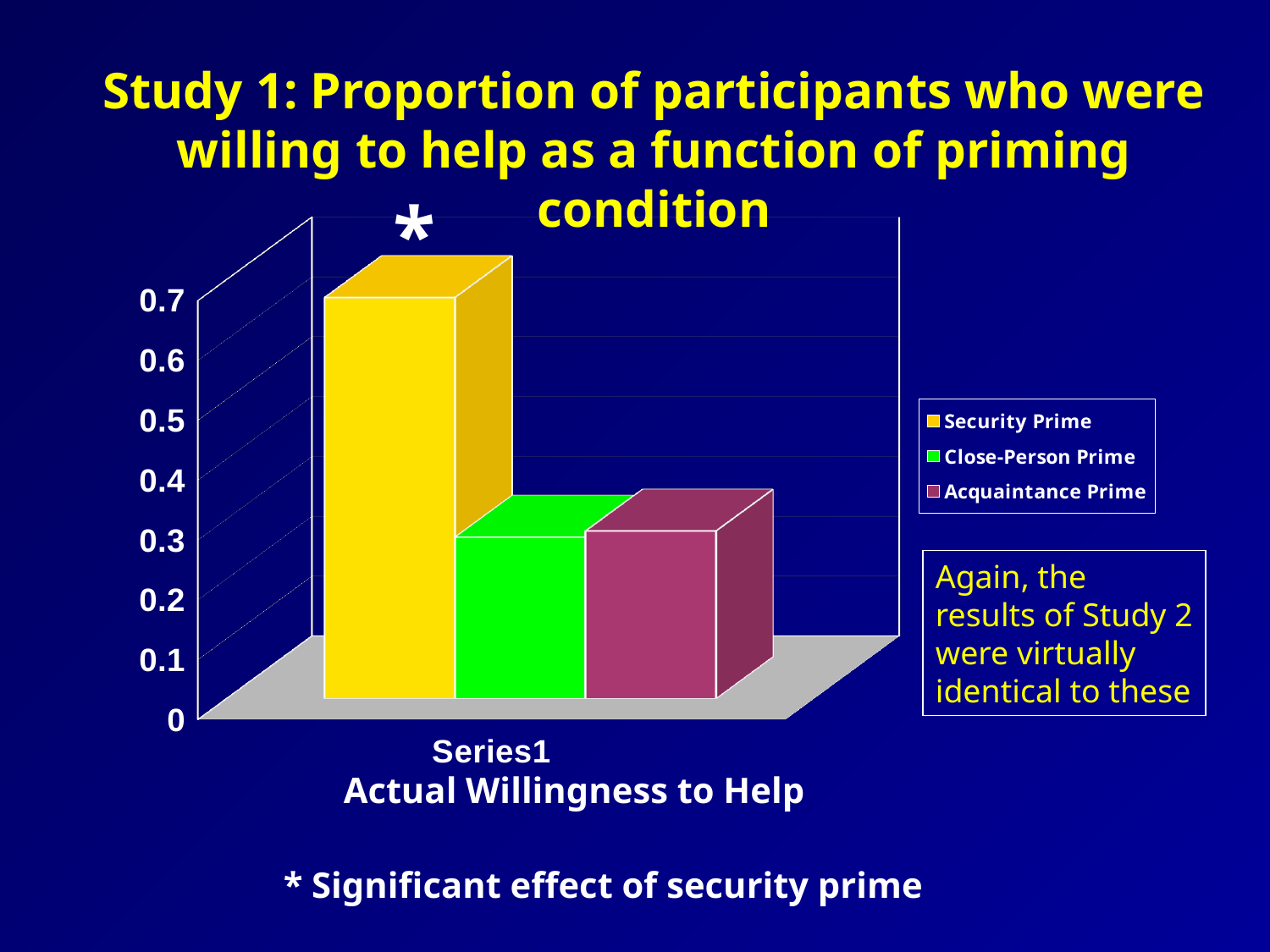
How many series does the legend list? 3 Which series is marked with an asterisk indicating a significant effect? Security Prime Is the value for Close-Person Prime greater or less than 0.5? less Which is larger, the value for Security Prime or the value for Acquaintance Prime? Security Prime How many categories are shown on the x axis? 1 Is the value for Security Prime greater or less than 0.5? greater What colour is the Security Prime bar? yellow Which series has the highest bar? Security Prime Which is larger, the value for Security Prime or the value for Close-Person Prime? Security Prime Is the value for Close-Person Prime greater or less than 0.2? greater What kind of chart is shown on the slide? bar chart